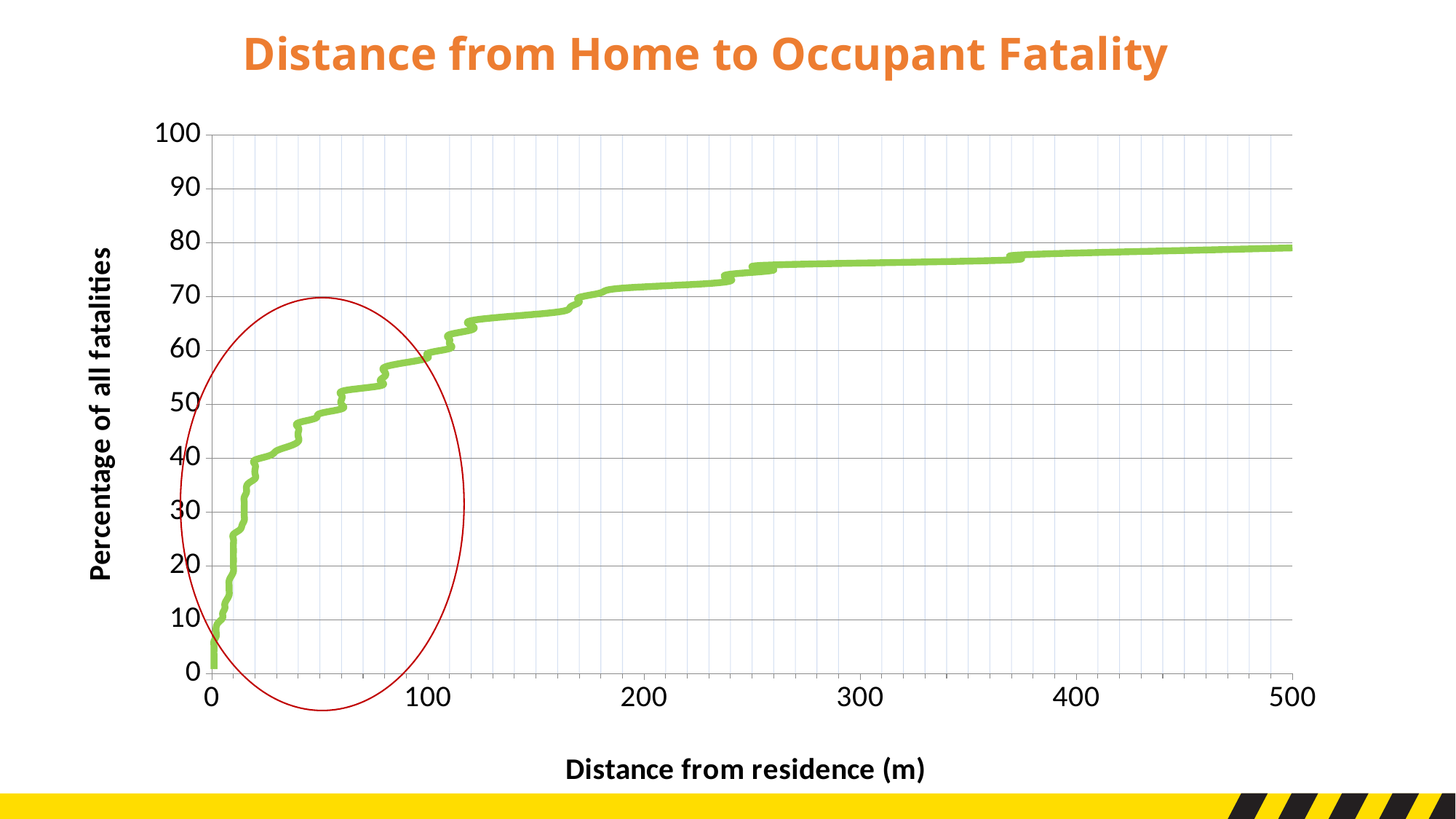
Is the percentage of all fatalities at a distance of 500 m greater or less than 80? less What is the label of the x axis? Distance from residence (m) Is the percentage of all fatalities at a distance of 400 m greater or less than 70? greater Does the percentage of all fatalities rise or fall as distance from residence increases? rise Is the highest value reached by the line greater or less than 80? less What is the title of the chart? Distance from Home to Occupant Fatality What kind of chart is shown on the slide? line chart